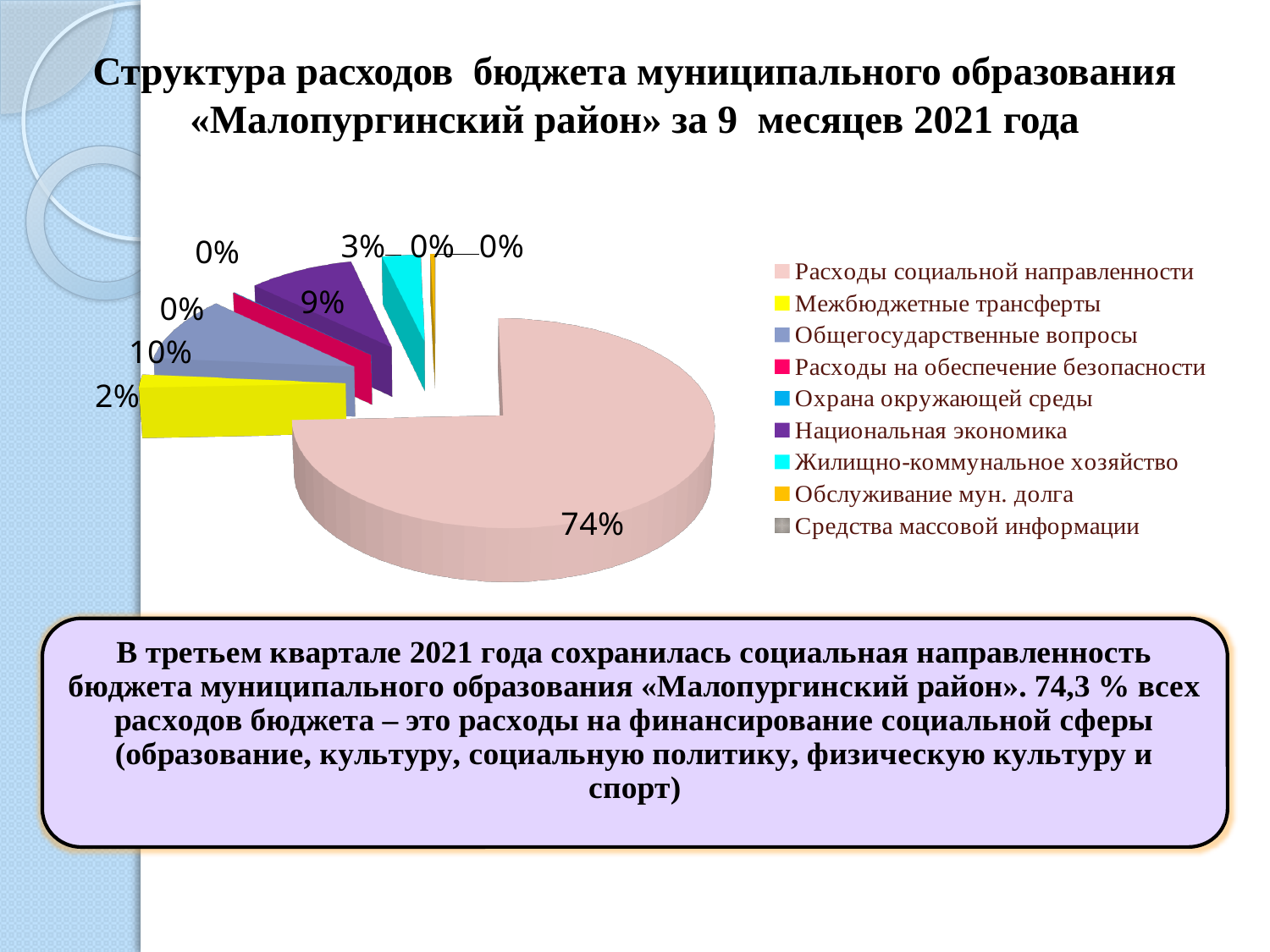
What colour represents Расходы социальной направленности in the legend? Pink What is the title of the chart on the slide? Структура расходов бюджета муниципального образования «Малопургинский район» за 9 месяцев 2021 года What share of the pie does Расходы социальной направленности have? 74% What share of the pie does Жилищно-коммунальное хозяйство have? 3% Which is larger: the share for Расходы социальной направленности or the share for Национальная экономика? Расходы социальной направленности By how many percentage points does the share for Расходы социальной направленности exceed the share for Национальная экономика? 65 Which category has the largest share of the pie? Расходы социальной направленности What share of the pie does Национальная экономика have? 9% How many categories does the legend list? 9 How many slices are labelled with a percentage on the pie? 9 What kind of chart is shown on the slide? Pie chart